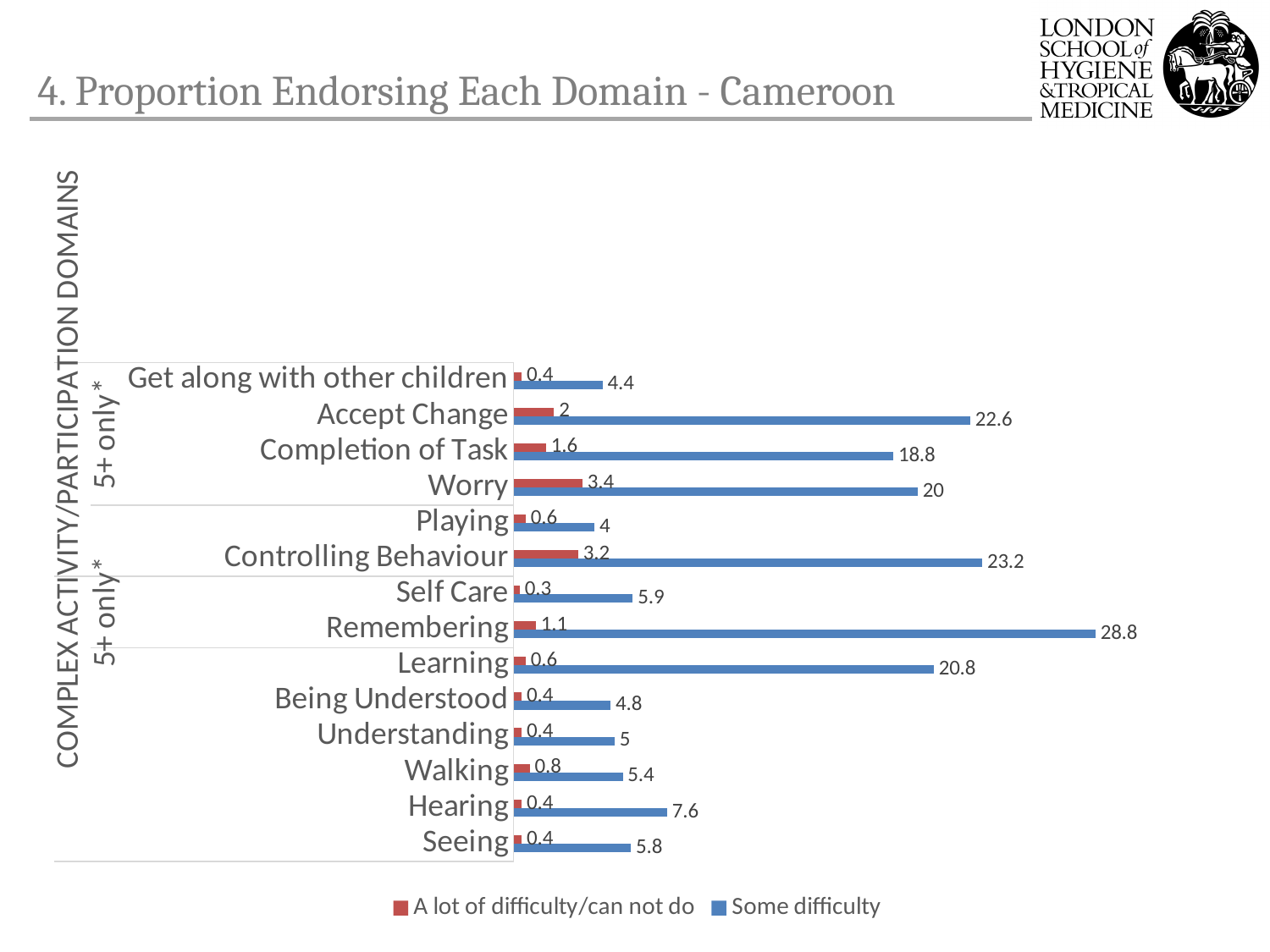
What is the 'Some difficulty' value for Hearing? 7.6 How many series does the legend list? 2 Which domain has the lowest 'Some difficulty' value? Playing What is the 'Some difficulty' value for Remembering? 28.8 Which domain has the highest 'Some difficulty' value? Remembering Which has a larger 'Some difficulty' value, Controlling Behaviour or Learning? Controlling Behaviour What is the difference between the 'Some difficulty' values for Accept Change and Completion of Task? 3.8 What type of chart is shown on the slide? Bar chart What is the 'A lot of difficulty/can not do' value for Worry? 3.4 What is the title of the chart on the slide? 4. Proportion Endorsing Each Domain - Cameroon Which domain has the lowest 'A lot of difficulty/can not do' value? Self Care How many domains (categories) are plotted in the chart? 14